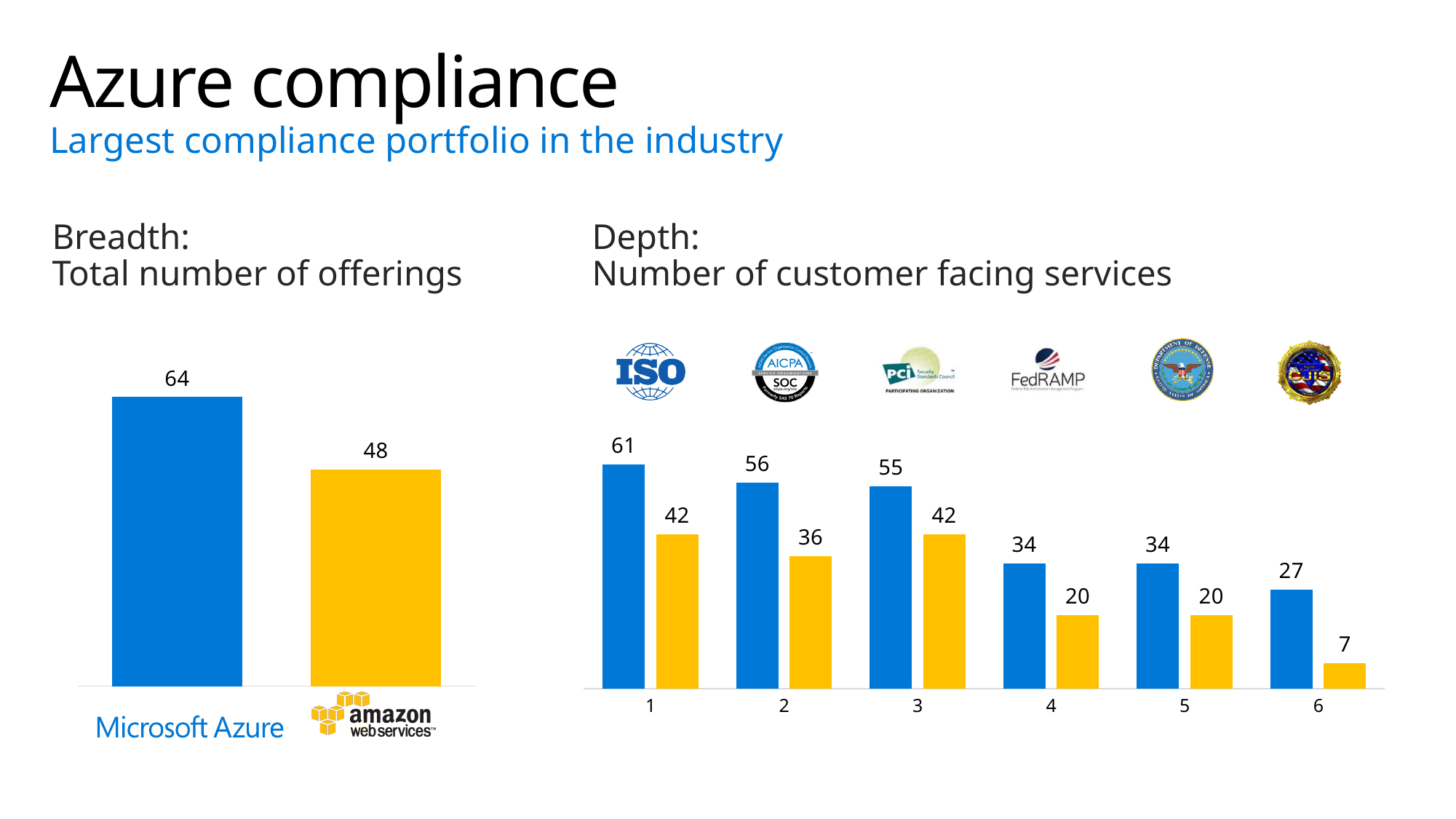
What kind of chart is the Depth chart on the right? Bar chart In the Depth chart, what is the value of the yellow bar for category 2? 36 In the Breadth chart, what is the total number of offerings for Microsoft Azure? 64 In the Depth chart, what is the difference between the blue and yellow bars for category 3? 13 In the Breadth chart, what is the total number of offerings for Amazon Web Services? 48 In the Depth chart, which category has the highest blue bar? 1 In the Breadth chart, what is the difference between the Microsoft Azure and Amazon Web Services values? 16 In the Breadth chart, which has more offerings, Microsoft Azure or Amazon Web Services? Microsoft Azure In the Depth chart, what is the value of the yellow bar for category 6? 7 In the Depth chart, which category has the lowest yellow bar? 6 In the Depth chart, what is the value of the blue bar for category 1? 61 How many categories are shown on the x axis of the Depth chart? 6